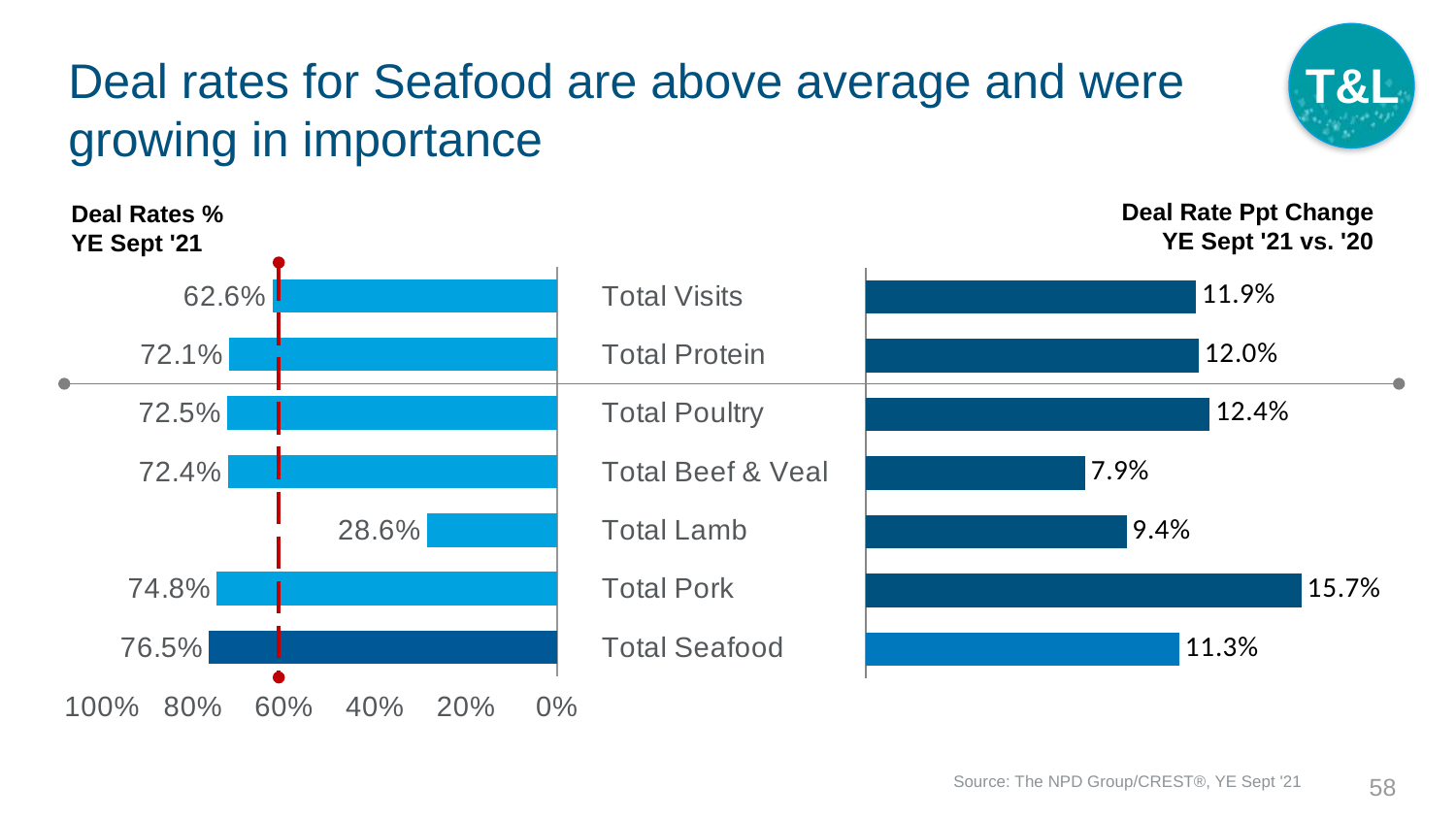
In the 'Deal Rates % YE Sept '21' chart, which category has the highest value? Total Seafood What kind of chart is the 'Deal Rates % YE Sept '21' chart? Bar chart In the 'Deal Rate Ppt Change YE Sept '21 vs. '20' chart, what is the difference between Total Pork and Total Lamb? 6.3% In the 'Deal Rates % YE Sept '21' chart, which category has the lowest value? Total Lamb In the 'Deal Rates % YE Sept '21' chart, what is the value for Total Seafood? 76.5% In the 'Deal Rate Ppt Change YE Sept '21 vs. '20' chart, which is larger, Total Poultry or Total Seafood? Total Poultry In the 'Deal Rates % YE Sept '21' chart, what is the value for Total Protein? 72.1% How many categories are shown in the 'Deal Rates % YE Sept '21' chart? 7 In the 'Deal Rate Ppt Change YE Sept '21 vs. '20' chart, what is the value for Total Pork? 15.7% In the 'Deal Rate Ppt Change YE Sept '21 vs. '20' chart, which category has the highest value? Total Pork In the 'Deal Rates % YE Sept '21' chart, what is the difference between Total Seafood and Total Visits? 13.9% In the 'Deal Rate Ppt Change YE Sept '21 vs. '20' chart, which category has the lowest value? Total Beef & Veal